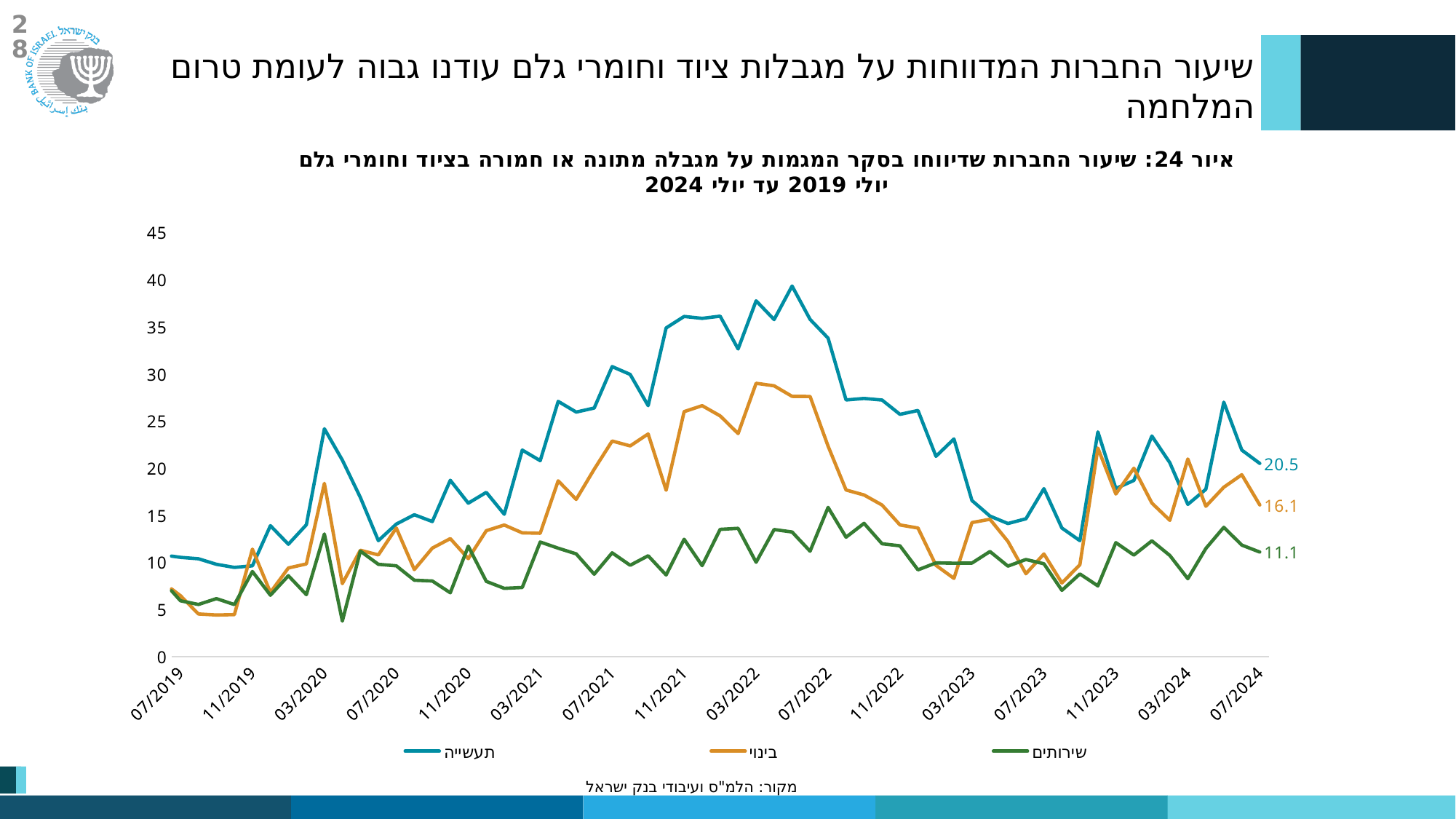
What is the value of the תעשייה series at 07/2024? 20.5 What type of chart is shown on the slide? line chart Is the peak value of the תעשייה line greater or less than 35? greater What is the value of the בינוי series at 07/2024? 16.1 Which series has the lowest value at 07/2024? שירותים What is the difference between the בינוי and שירותים values at 07/2024? 5.0 What is the difference between the תעשייה and בינוי values at 07/2024? 4.4 Which series has the highest value at 07/2024? תעשייה How many series does the legend list? 3 What is the value of the שירותים series at 07/2024? 11.1 Is the value for בינוי at 07/2019 greater or less than 10? less Which colour is used for the שירותים series? green